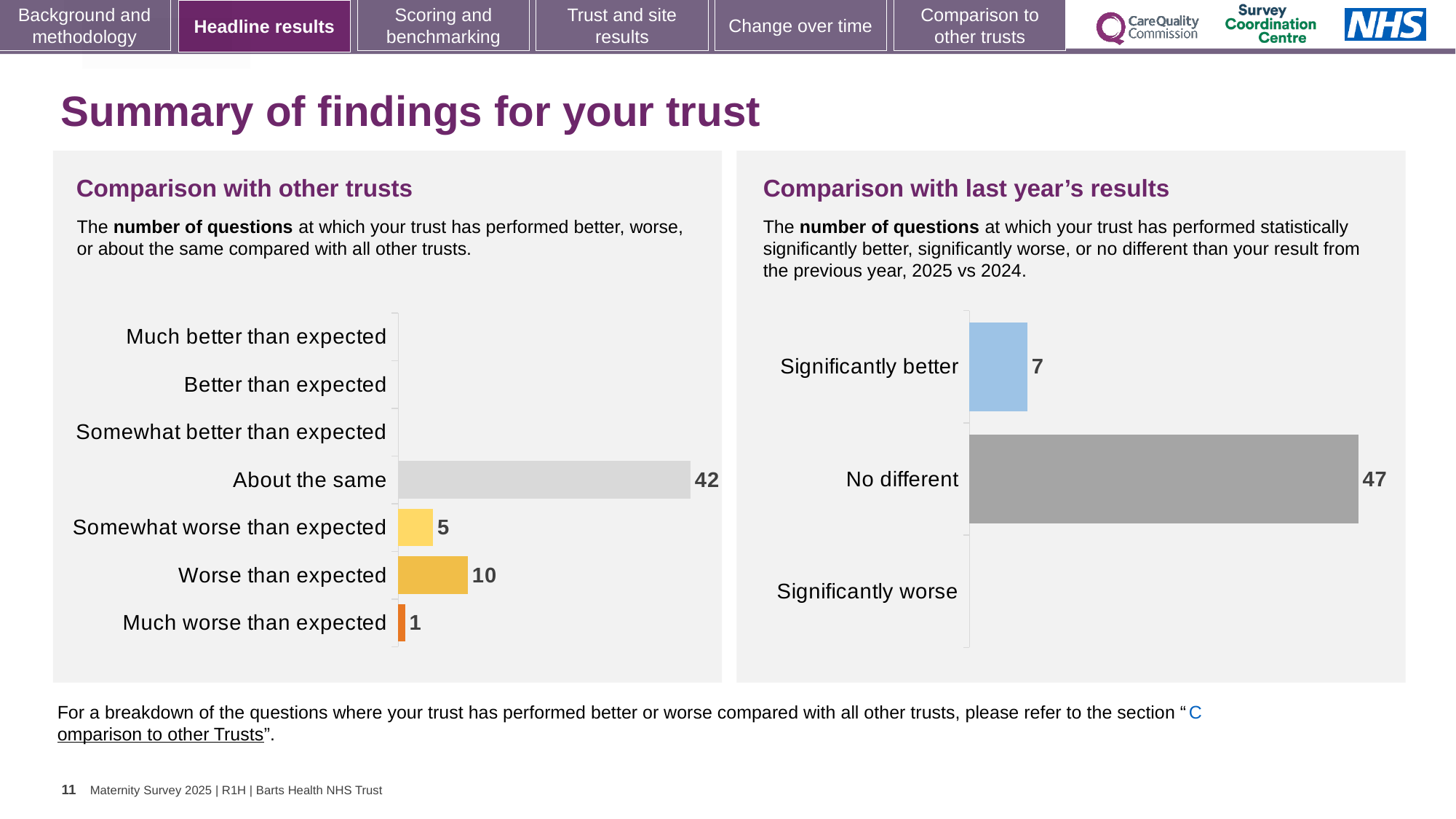
In the 'Comparison with last year's results' chart, what is the value for 'No different'? 47 In the 'Comparison with other trusts' chart, which is larger: 'Somewhat worse than expected' or 'Much worse than expected'? Somewhat worse than expected In the 'Comparison with last year's results' chart, which category has the highest value? No different What kind of chart is the 'Comparison with last year's results' chart? Bar chart In the 'Comparison with other trusts' chart, what is the value for 'About the same'? 42 In the 'Comparison with other trusts' chart, what is the difference between 'Worse than expected' and 'Somewhat worse than expected'? 5 In the 'Comparison with other trusts' chart, which category has the highest value? About the same In the 'Comparison with last year's results' chart, what is the difference between 'No different' and 'Significantly better'? 40 In the 'Comparison with other trusts' chart, what is the value for 'Much worse than expected'? 1 In the 'Comparison with other trusts' chart, how many categories are listed on the axis? 7 In the 'Comparison with last year's results' chart, what is the value for 'Significantly better'? 7 In the 'Comparison with other trusts' chart, what is the value for 'Worse than expected'? 10